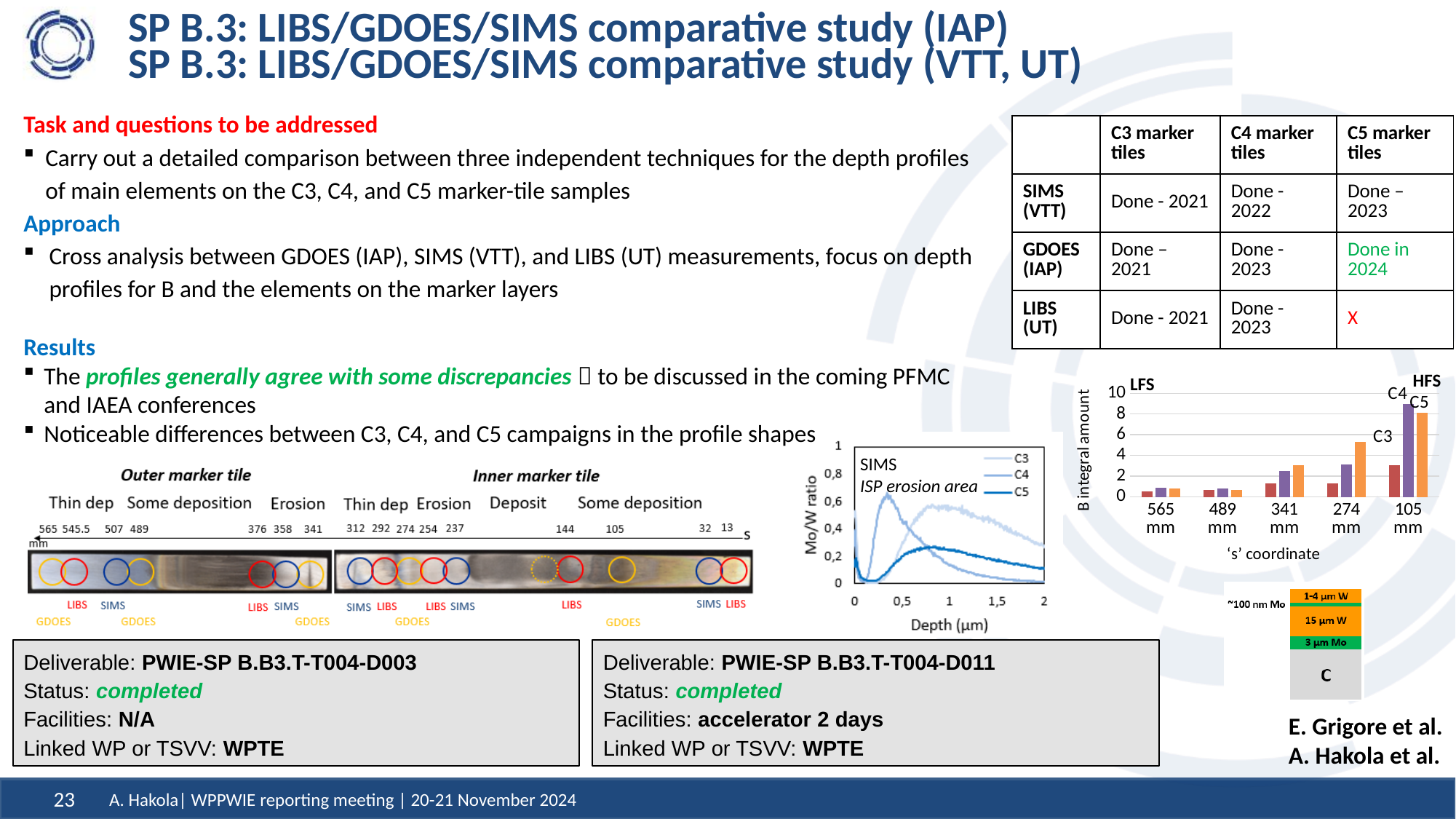
In the SIMS Mo/W ratio chart, is the peak value of the C4 curve greater or less than 0.6? greater In the B integral amount bar chart, which 's' coordinate has the tallest bars? 105 mm In the B integral amount bar chart, how many 's' coordinate categories are shown on the x axis? 5 What kind of chart is the SIMS chart plotting Mo/W ratio against depth? line chart In the B integral amount bar chart, which is larger at 105 mm, the C4 bar or the C3 bar? C4 In the B integral amount bar chart, is the C3 value at 105 mm greater or less than 4? less How many series does the legend of the SIMS Mo/W ratio chart list? 3 What kind of chart is the chart on the right showing B integral amount against the 's' coordinate? bar chart In the B integral amount bar chart, is the C4 value at 105 mm greater or less than 8? greater In the B integral amount bar chart, what is the label of the y axis? B integral amount In the SIMS Mo/W ratio chart, does the C5 curve rise or fall between a depth of 1 µm and 2 µm? fall